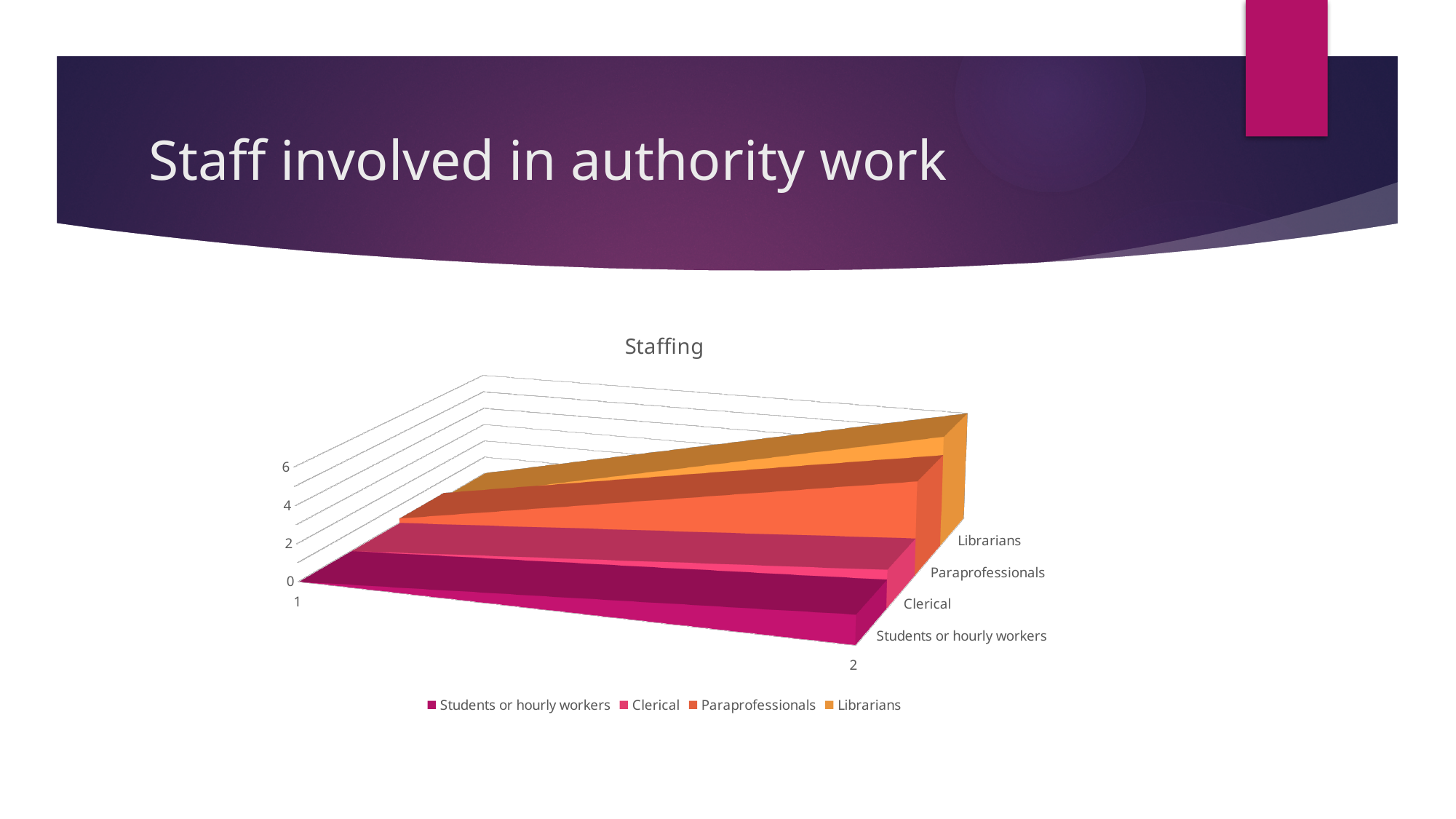
How many series does the legend list? 4 Which series has the highest value at point 2? Librarians At point 2, is the value for Paraprofessionals larger or smaller than the value for Students or hourly workers? larger Which series are listed in the legend? Students or hourly workers, Clerical, Paraprofessionals, Librarians What kind of chart is shown on the slide? 3D area chart At point 2, is the value for Librarians larger or smaller than the value for Clerical? larger What is the title of the chart? Staffing Do the values for Students or hourly workers rise or fall from point 1 to point 2? rise How many points are there along the x axis? 2 Which series has the lowest value at point 2? Students or hourly workers Do the values for Librarians rise or fall from point 1 to point 2? rise